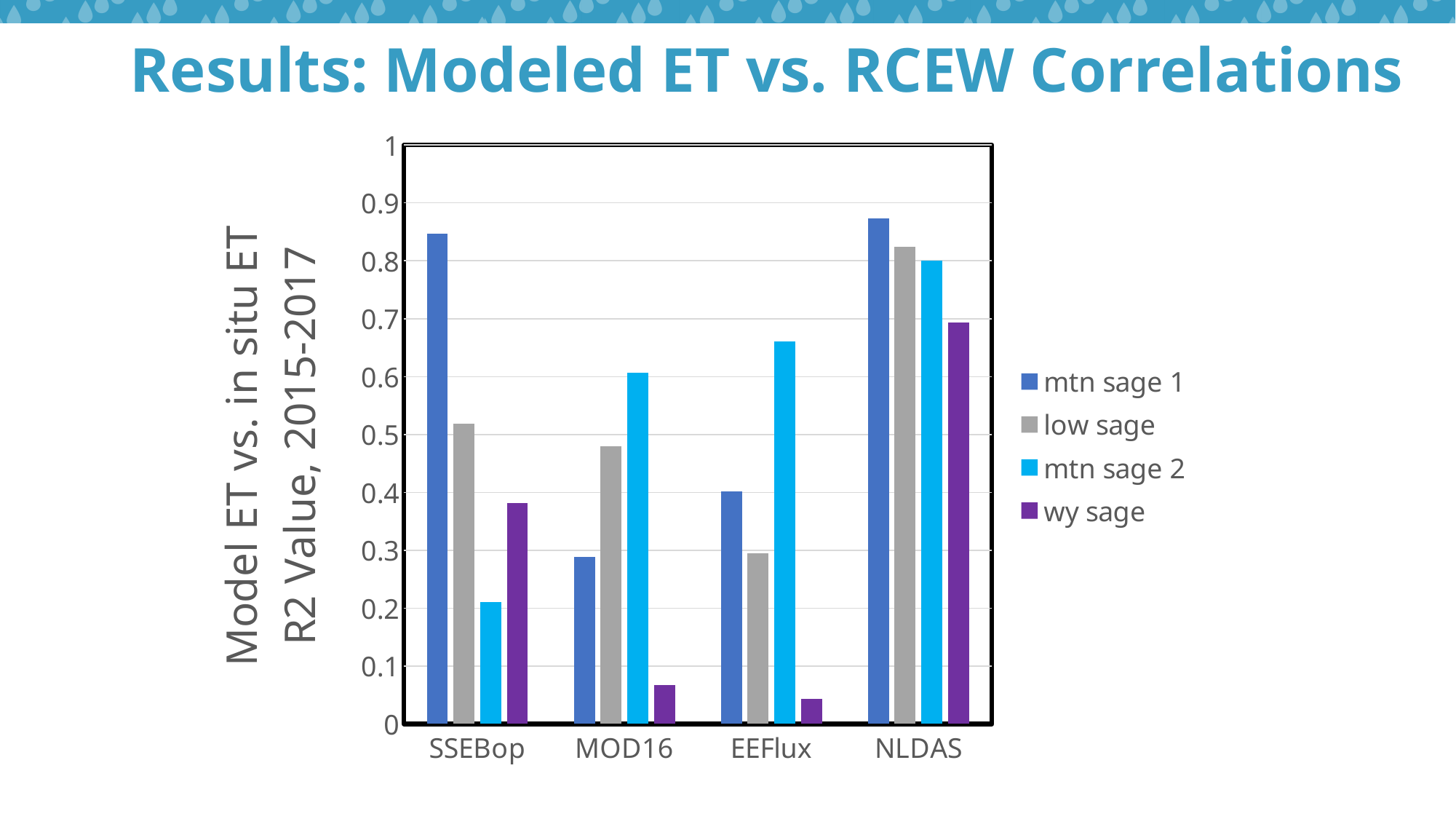
Is the R2 value for mtn sage 2 at EEFlux greater or less than 0.6? greater What is the y-axis label of the chart? Model ET vs. in situ ET R2 Value, 2015-2017 Is the R2 value for wy sage at MOD16 greater or less than 0.1? less Which model has the lowest R2 value for mtn sage 2? SSEBop Is the R2 value for mtn sage 1 at SSEBop greater or less than 0.8? greater Which model has the highest R2 value for wy sage? NLDAS Which model has the highest R2 value for mtn sage 2? NLDAS How many model categories are shown on the x axis? 4 How many series does the legend list? 4 For SSEBop, which is larger: the R2 value for low sage or for mtn sage 2? low sage Which model has the lowest R2 value for mtn sage 1? MOD16 What kind of chart is shown on the slide? bar chart